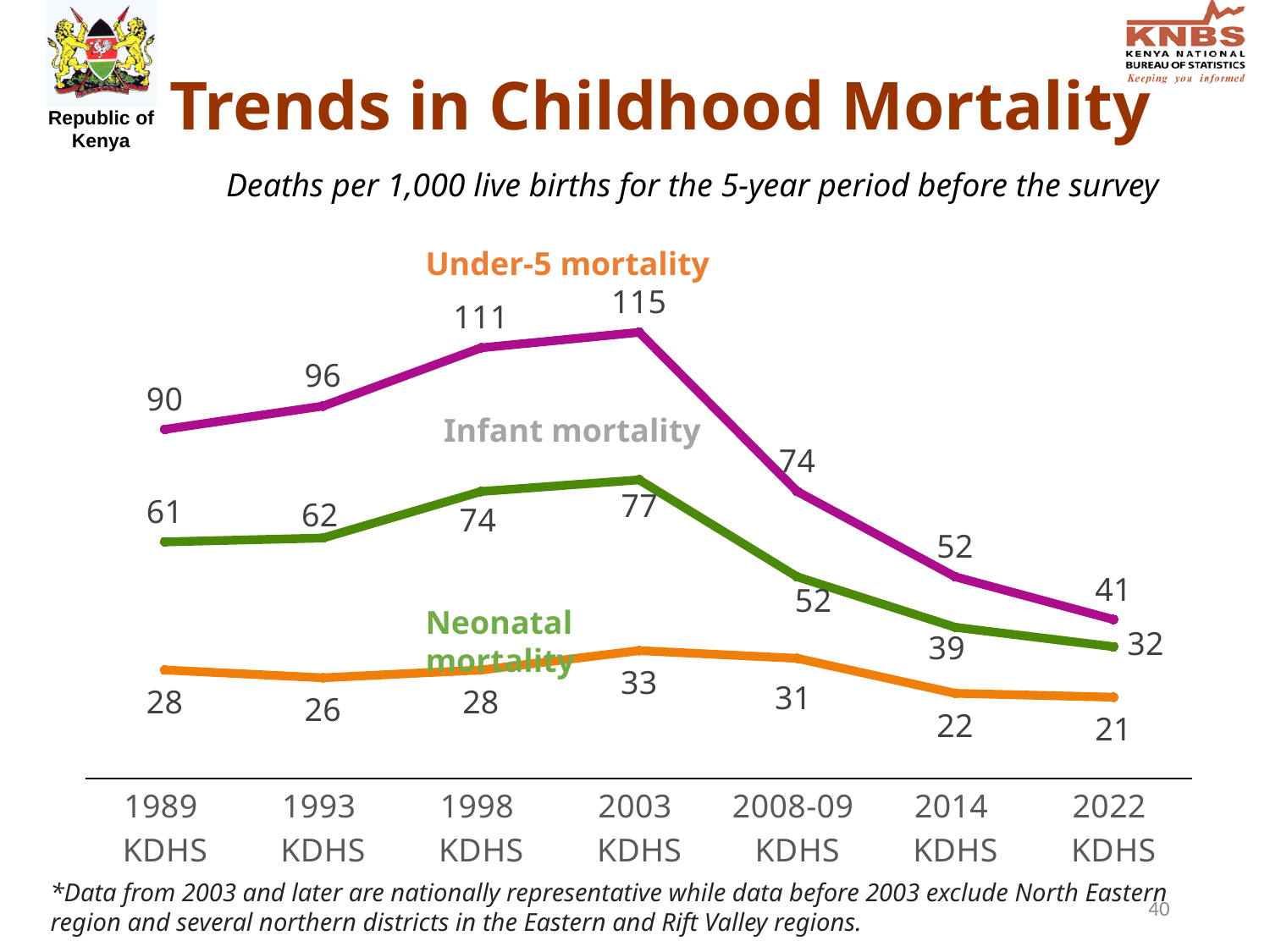
What is the difference between under-5 mortality in the 1989 KDHS and the 2022 KDHS? 49 What is the title of the slide's chart? Trends in Childhood Mortality How many surveys are shown on the x axis? 7 What is the under-5 mortality value for the 2003 KDHS? 115 What is the neonatal mortality value for the 1993 KDHS? 26 What is the infant mortality value for the 2014 KDHS? 39 In which survey is under-5 mortality highest? 2003 KDHS What kind of chart is shown on the slide? Line chart In which survey is neonatal mortality lowest? 2022 KDHS Does under-5 mortality rise or fall from the 2003 KDHS to the 2022 KDHS? Fall Which is larger: infant mortality in the 1998 KDHS or infant mortality in the 2008-09 KDHS? 1998 KDHS How many mortality series are plotted on the chart? 3